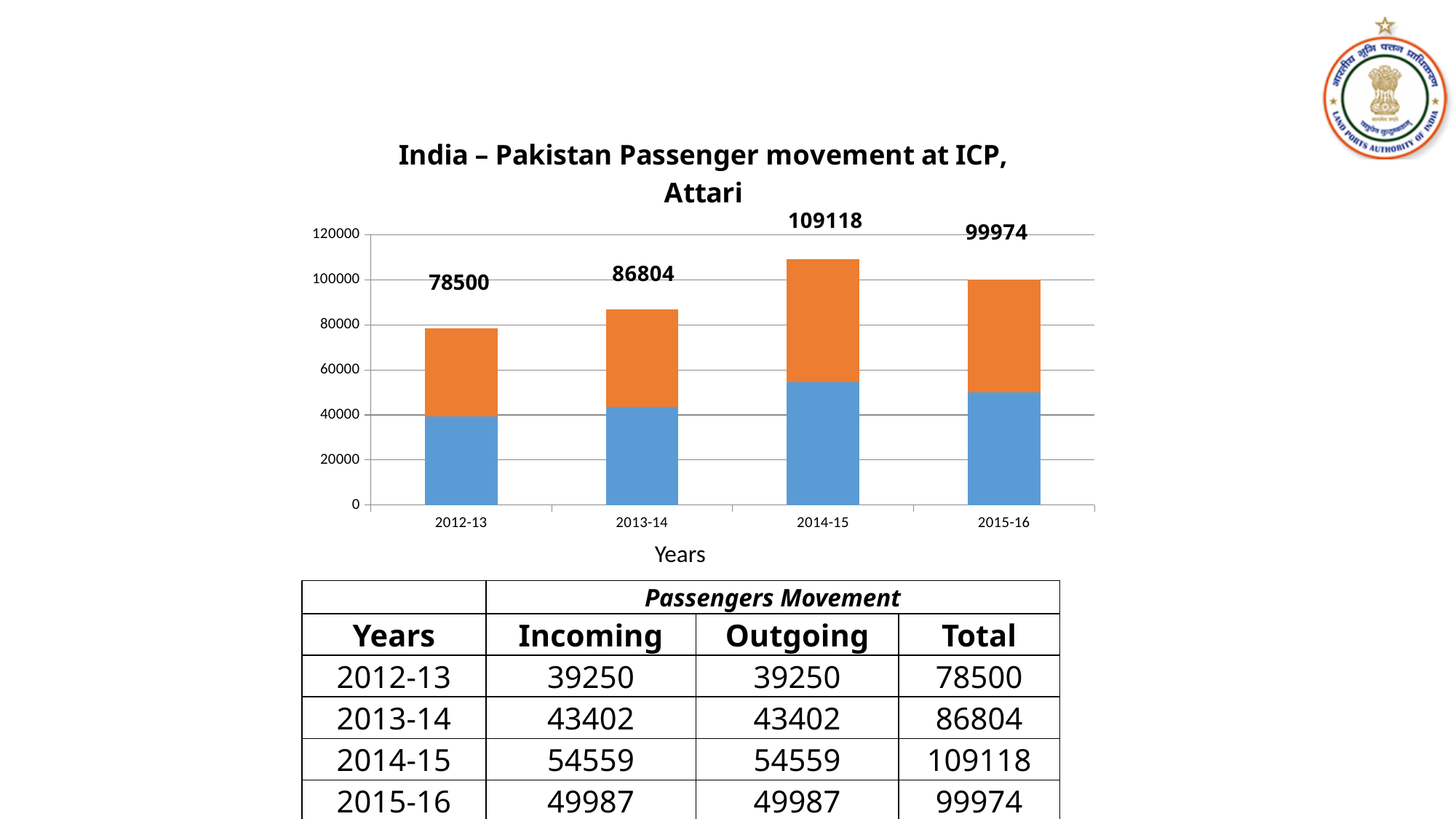
Which year has the highest total passenger movement? 2014-15 How many years are shown on the x axis of the chart? 4 Is the total for 2015-16 greater or less than 100000? less What is the difference between the total for 2014-15 and the total for 2013-14? 22314 Which year has a larger total, 2013-14 or 2015-16? 2015-16 What is the title of the chart? India – Pakistan Passenger movement at ICP, Attari Do the total values rise or fall from 2012-13 to 2014-15? rise What kind of chart is shown on the slide? stacked bar chart What is the total passenger movement shown for 2015-16? 99974 What is the total passenger movement shown for 2014-15? 109118 What is the total passenger movement shown for 2012-13? 78500 Which year has the lowest total passenger movement? 2012-13